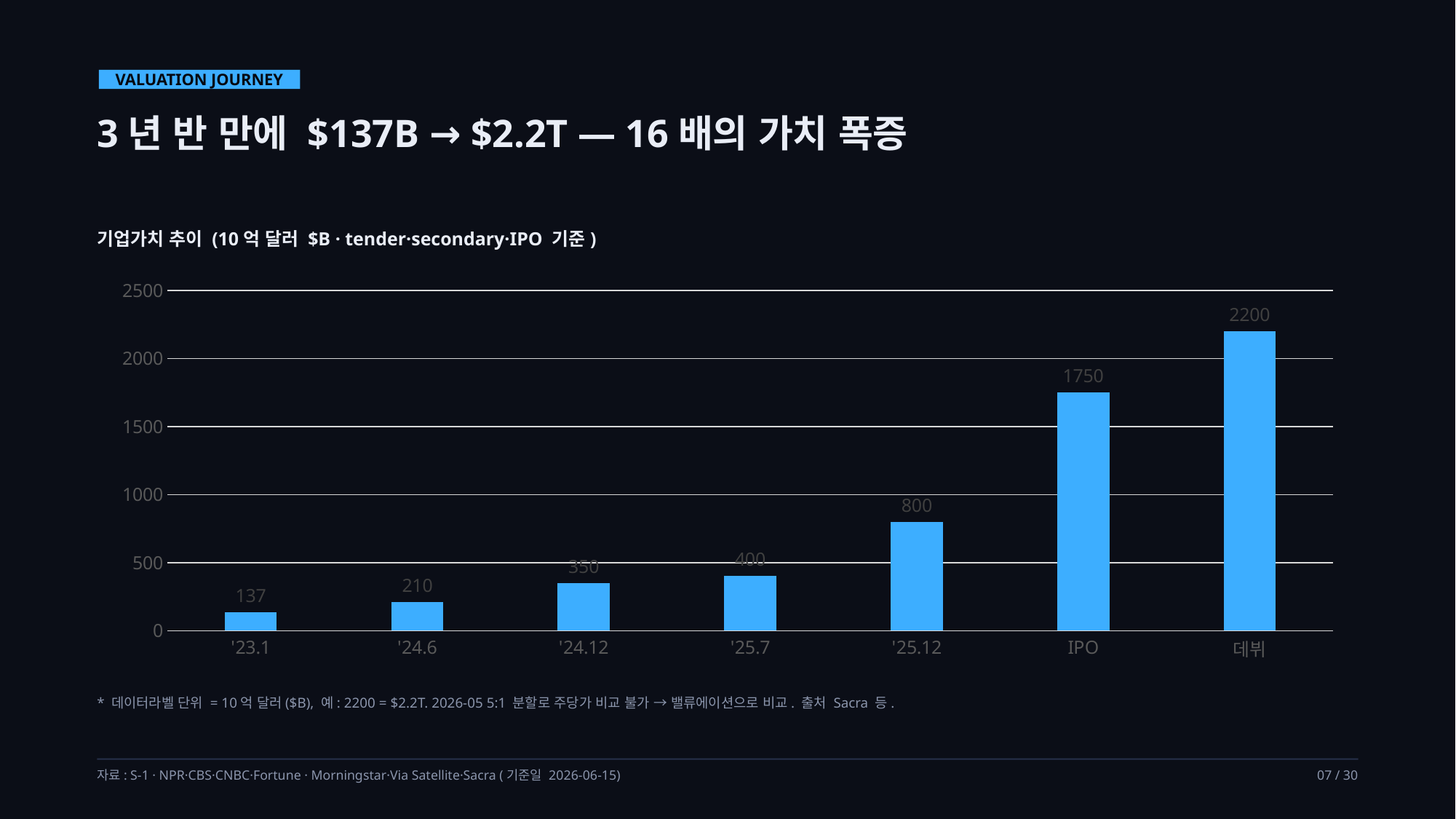
What is the difference between the values for '25.12 and '25.7? 400 Which category has the lowest value? '23.1 Which is larger, the value for '24.6 or the value for '25.7? '25.7 What is the value for 데뷔? 2200 What is the value for '23.1? 137 Do the values rise or fall from left to right along the x axis? rise Is the value for '24.12 greater or less than 500? less Which category has the highest value? 데뷔 What is the value for IPO? 1750 What is the value for '25.12? 800 What is the difference between the values for 데뷔 and IPO? 450 How many categories are shown on the x axis? 7